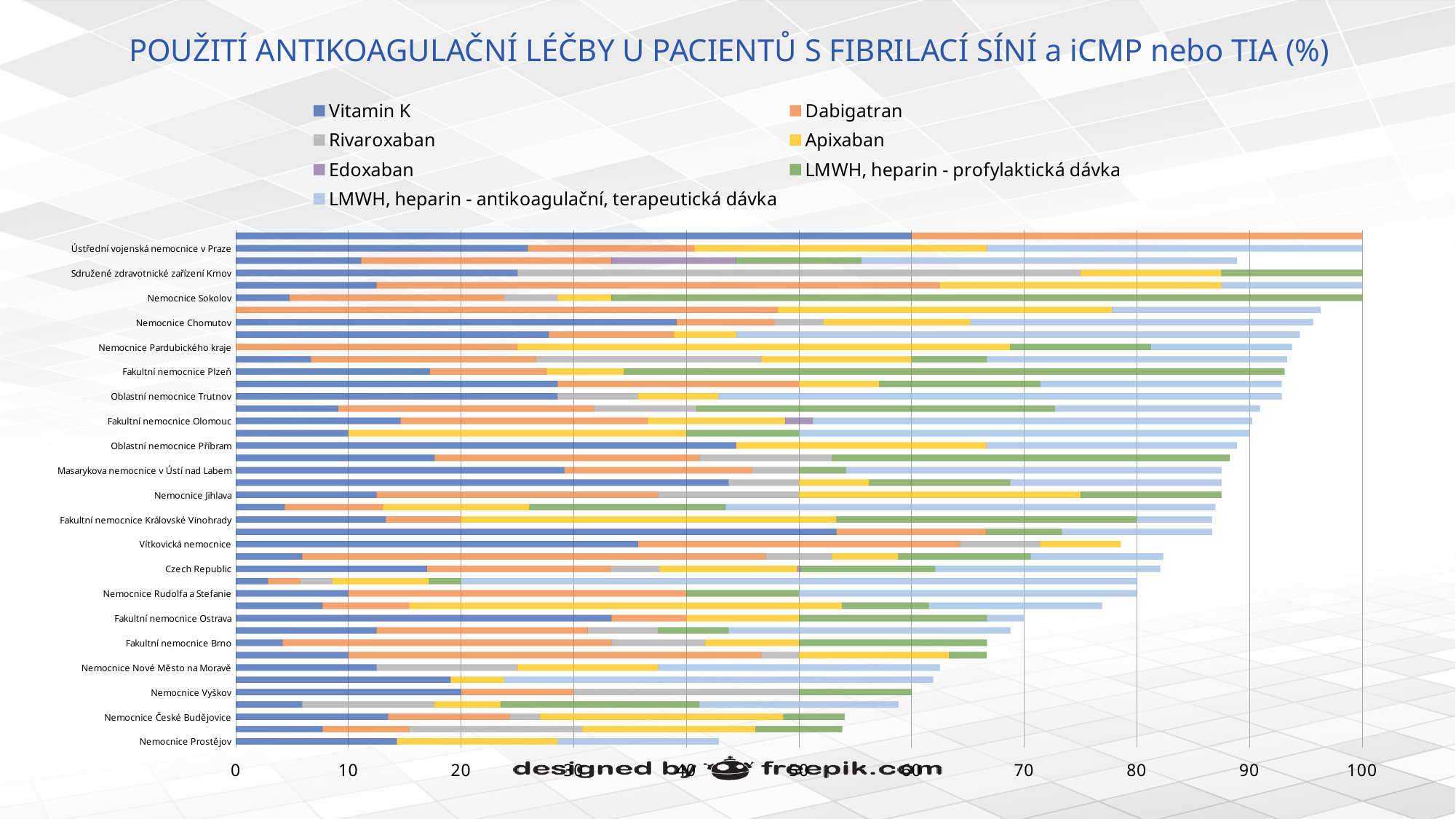
Which hospital has the lowest total bar? Nemocnice Prostějov Is the Vitamin K value for Nemocnice Sokolov greater or less than 10? less What kind of chart is shown on the slide? bar chart What is the title of the chart? POUŽITÍ ANTIKOAGULAČNÍ LÉČBY U PACIENTŮ S FIBRILACÍ SÍNÍ a iCMP nebo TIA (%) Which has the larger total bar, Nemocnice Prostějov or Nemocnice Vyškov? Nemocnice Vyškov Is the total bar for Nemocnice Prostějov greater or less than 50? less How many series does the legend list? 7 Which colour represents Edoxaban in the legend? purple Is the total bar for Fakultní nemocnice Brno greater or less than 60? greater Which has the larger Vitamin K value, Nemocnice Chomutov or Nemocnice Sokolov? Nemocnice Chomutov